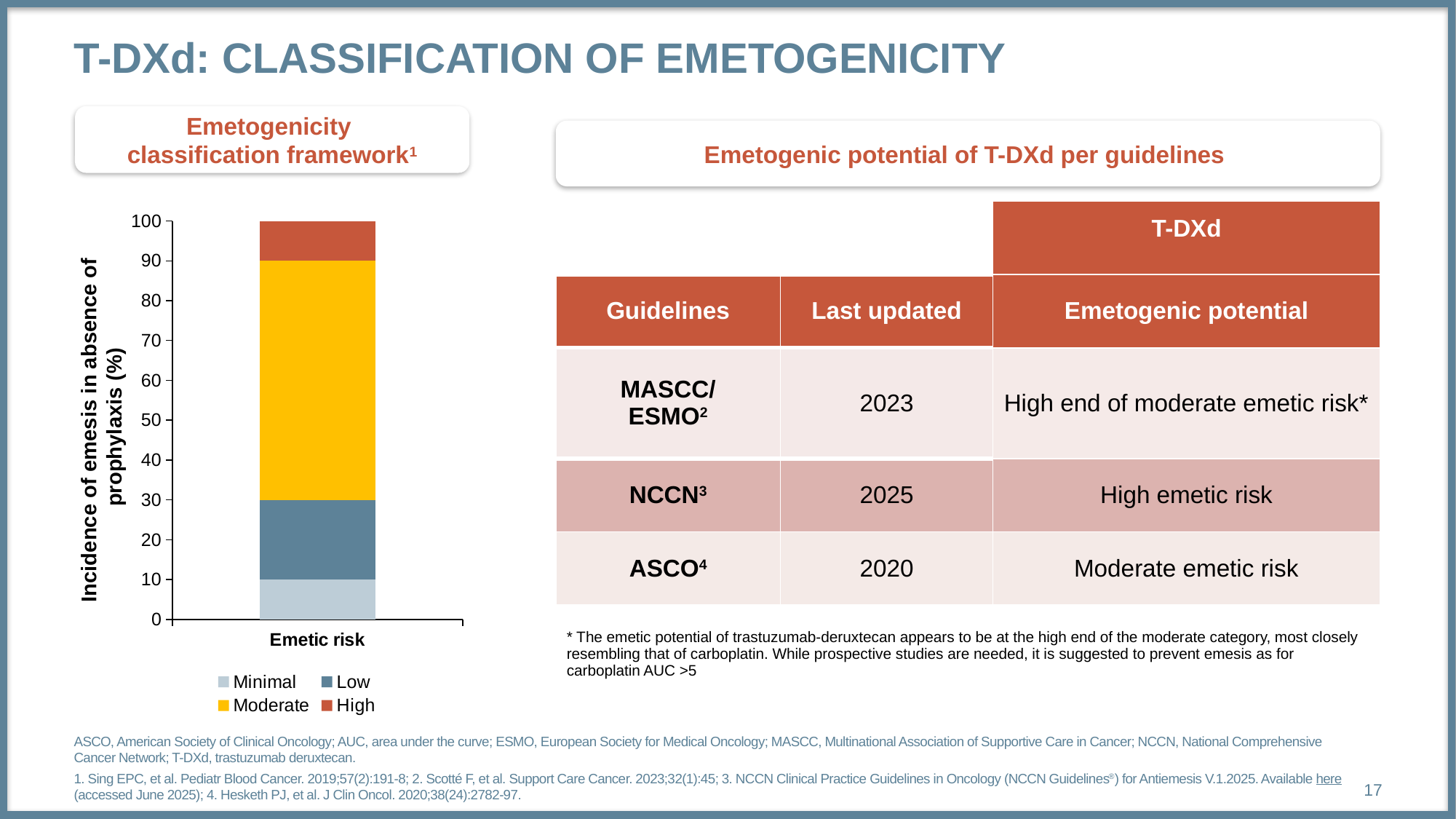
How many series does the legend of the bar chart list? 4 Which series occupies the largest segment of the stacked bar in the chart? Moderate In the bar chart, is the Moderate segment greater or less than 50 percentage points tall? greater How many categories are plotted on the x axis of the bar chart? 1 Which colour represents the Moderate series in the bar chart legend? Yellow At what value on the y axis does the top of the Minimal segment sit in the bar chart? 10 In the bar chart, is the Low segment greater or less than 30 percentage points tall? less In the bar chart, is the Moderate segment larger or smaller than the Low segment? Larger At what value on the y axis does the boundary between the Moderate and High segments sit in the bar chart? 90 What kind of chart is shown on the left of the slide? Stacked bar chart What is the total height of the stacked bar for Emetic risk in the chart? 100 What is the label of the y axis of the bar chart? Incidence of emesis in absence of prophylaxis (%)